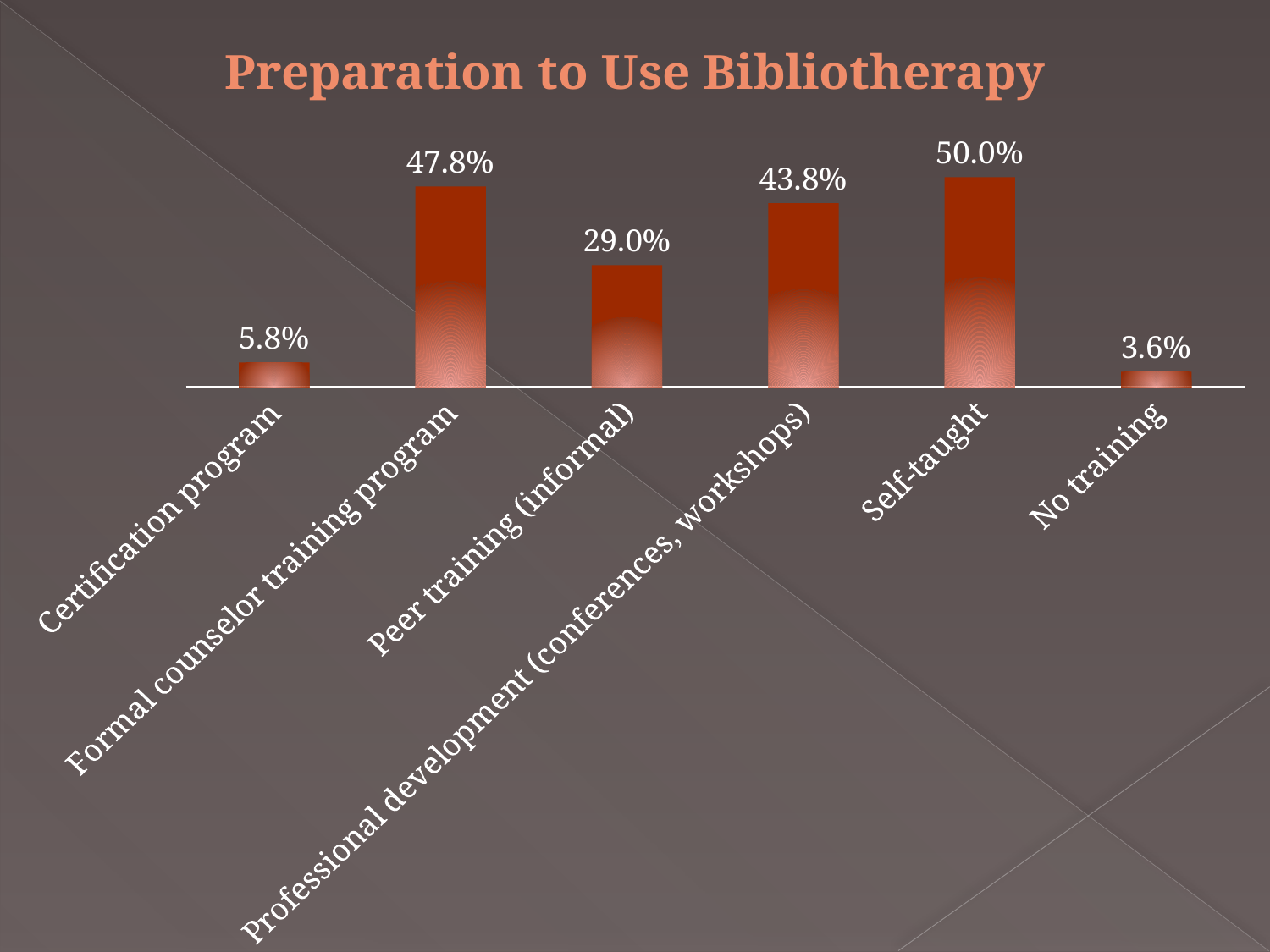
What is the difference between Formal counselor training program and Peer training (informal)? 18.8% What is the value for Peer training (informal)? 29.0% What is the value for Self-taught? 50.0% What is the title of the chart? Preparation to Use Bibliotherapy What is the difference between Self-taught and No training? 46.4% Which is larger, Formal counselor training program or Professional development (conferences, workshops)? Formal counselor training program How many categories are shown in the chart? 6 What is the value for Professional development (conferences, workshops)? 43.8% Which category has the lowest value? No training What is the value for Certification program? 5.8% What kind of chart is this? Bar chart Which category has the highest value? Self-taught